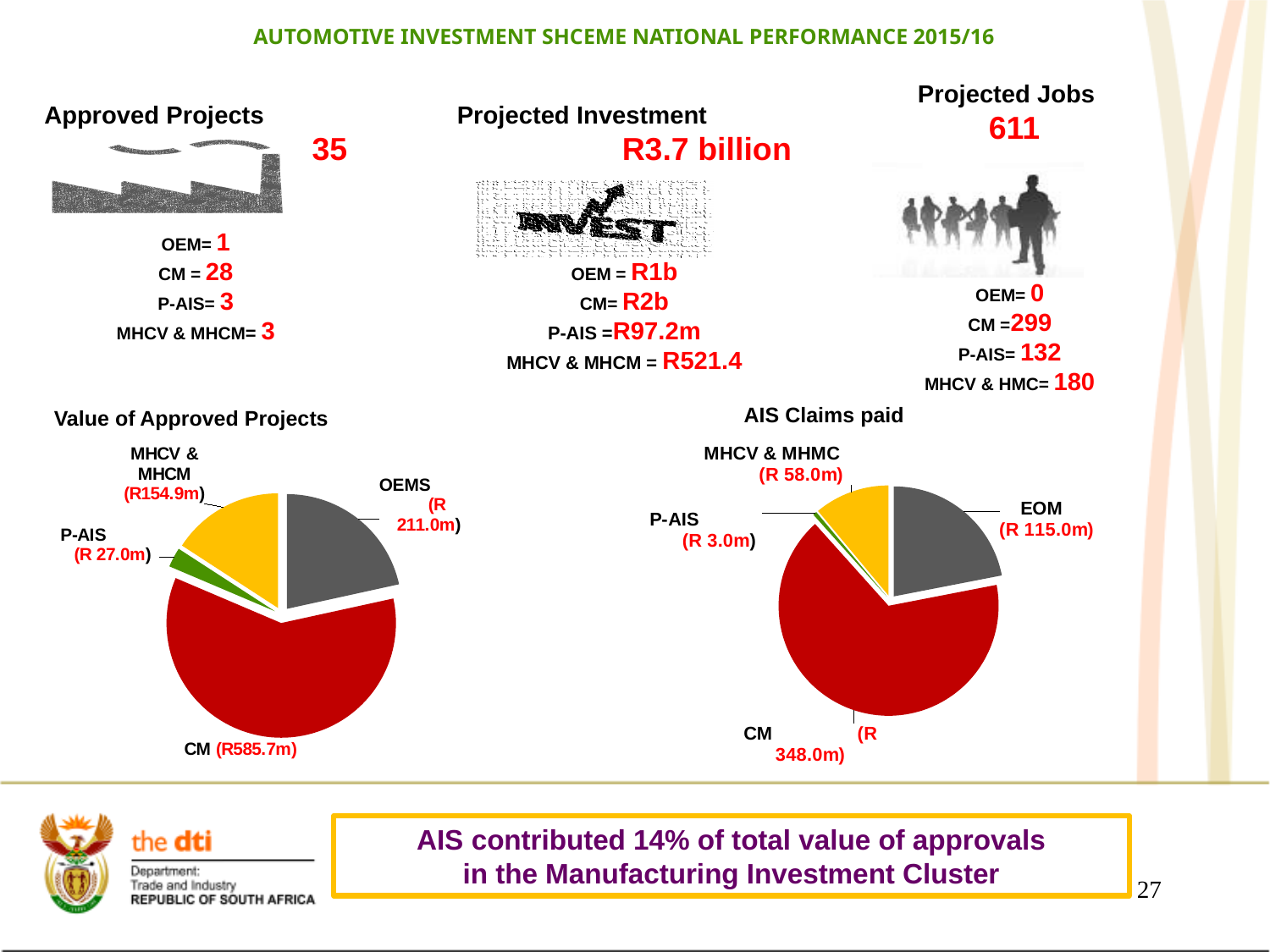
In the 'Value of Approved Projects' chart, which category has the largest slice? CM What type of chart is the 'AIS Claims paid' chart? Pie chart In the 'AIS Claims paid' chart, what is the value for MHCV & MHMC? R 58.0m In the 'AIS Claims paid' chart, what is the difference between CM and EOM? R 233.0m In the 'AIS Claims paid' chart, what is the value for EOM? R 115.0m In the 'Value of Approved Projects' chart, how many slices does the pie have? 4 In the 'AIS Claims paid' chart, which is larger, EOM or MHCV & MHMC? EOM In the 'AIS Claims paid' chart, which category has the smallest slice? P-AIS In the 'Value of Approved Projects' chart, which category has the smallest slice? P-AIS In the 'Value of Approved Projects' chart, what is the value for CM? R585.7m In the 'Value of Approved Projects' chart, what is the difference between OEMS and MHCV & MHCM? R 56.1m In the 'Value of Approved Projects' chart, what is the value for P-AIS? R 27.0m